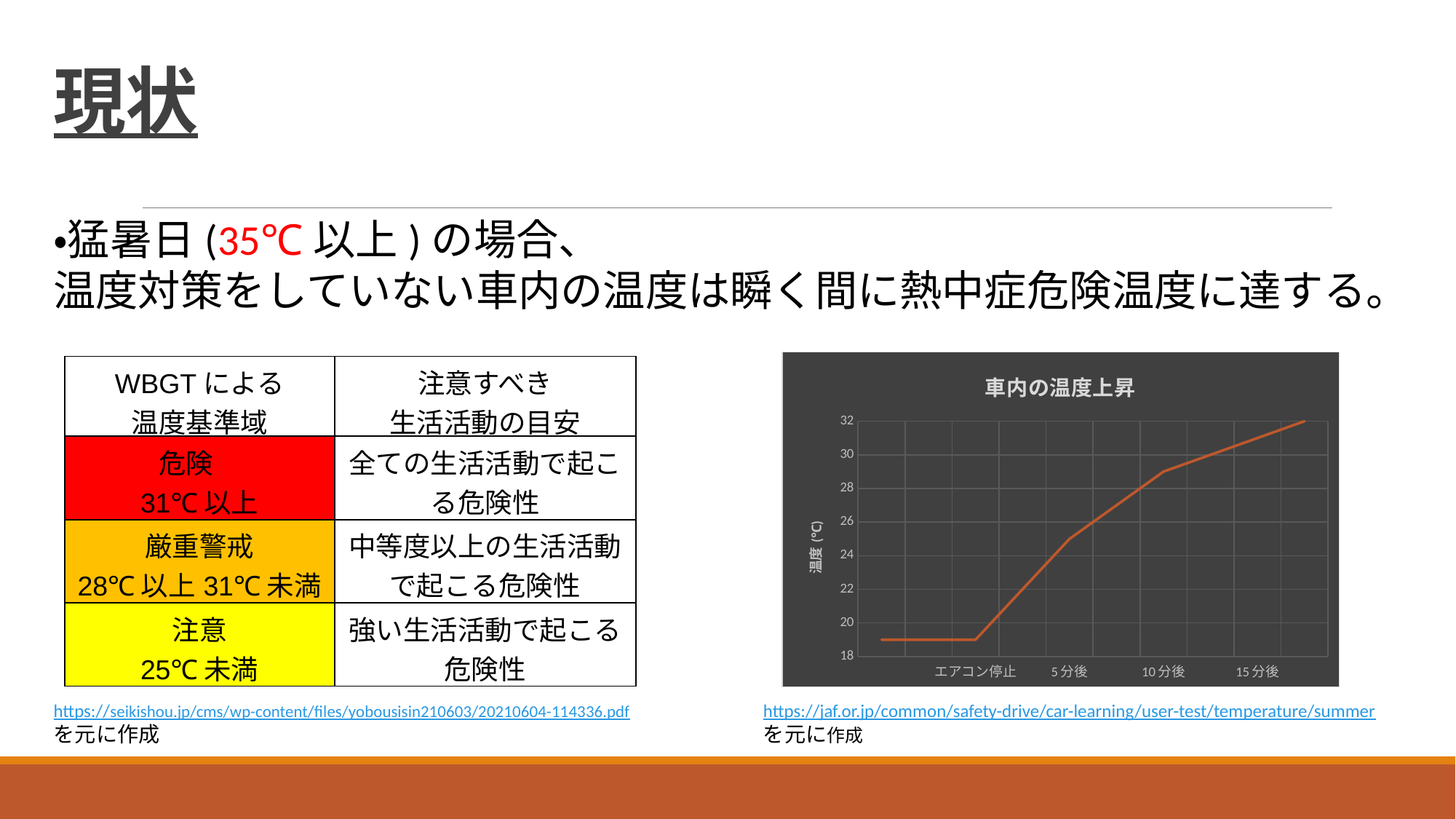
What kind of chart is shown on the slide? line chart Which is higher, the temperature at 10分後 or at 5分後? 10分後 Is the temperature at 10分後 greater or less than 26? greater How many time labels are shown on the x axis of the chart? 4 At which x-axis label is the temperature lowest? エアコン停止 Is the temperature at エアコン停止 greater or less than 20? less Is the temperature at 5分後 greater or less than 22? greater Do the values in the chart rise or fall from エアコン停止 to 15分後? rise What is the title of the chart on the slide? 車内の温度上昇 What is the label of the vertical axis of the chart? 温度 (℃) At which x-axis label is the temperature highest? 15分後